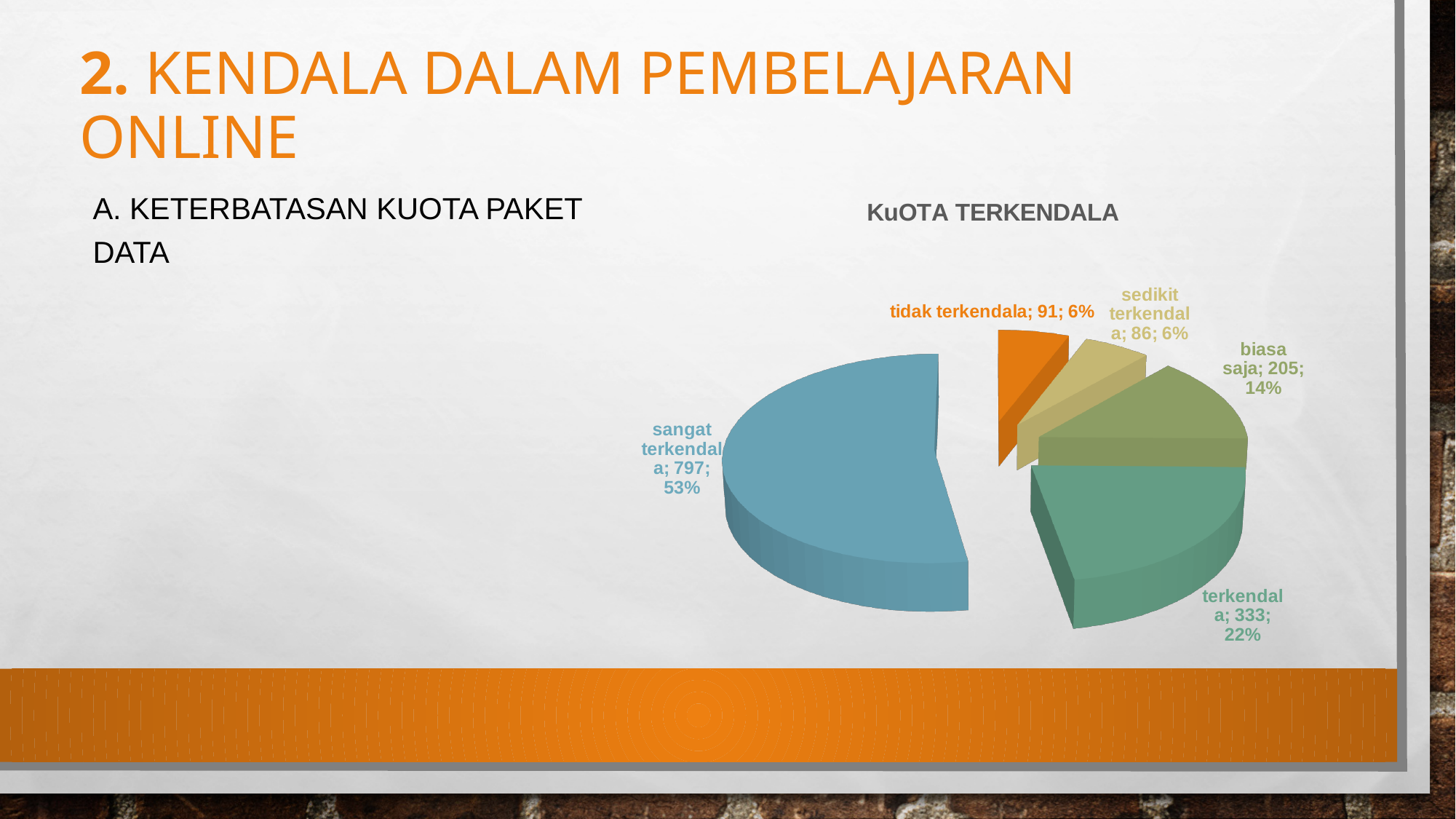
How many slices does the pie chart have? 5 Which is larger, the value for 'tidak terkendala' or 'sedikit terkendala'? tidak terkendala What kind of chart is shown on the slide? pie chart What share of the pie does 'sangat terkendala' represent? 53% What is the value for 'tidak terkendala'? 91 What share of the pie does 'biasa saja' represent? 14% What is the value for 'biasa saja'? 205 What is the difference between the values for 'terkendala' and 'biasa saja'? 128 What is the value for 'terkendala'? 333 What is the title of the chart? KuOTA TERKENDALA Which category has the largest slice? sangat terkendala What is the value for 'sangat terkendala'? 797